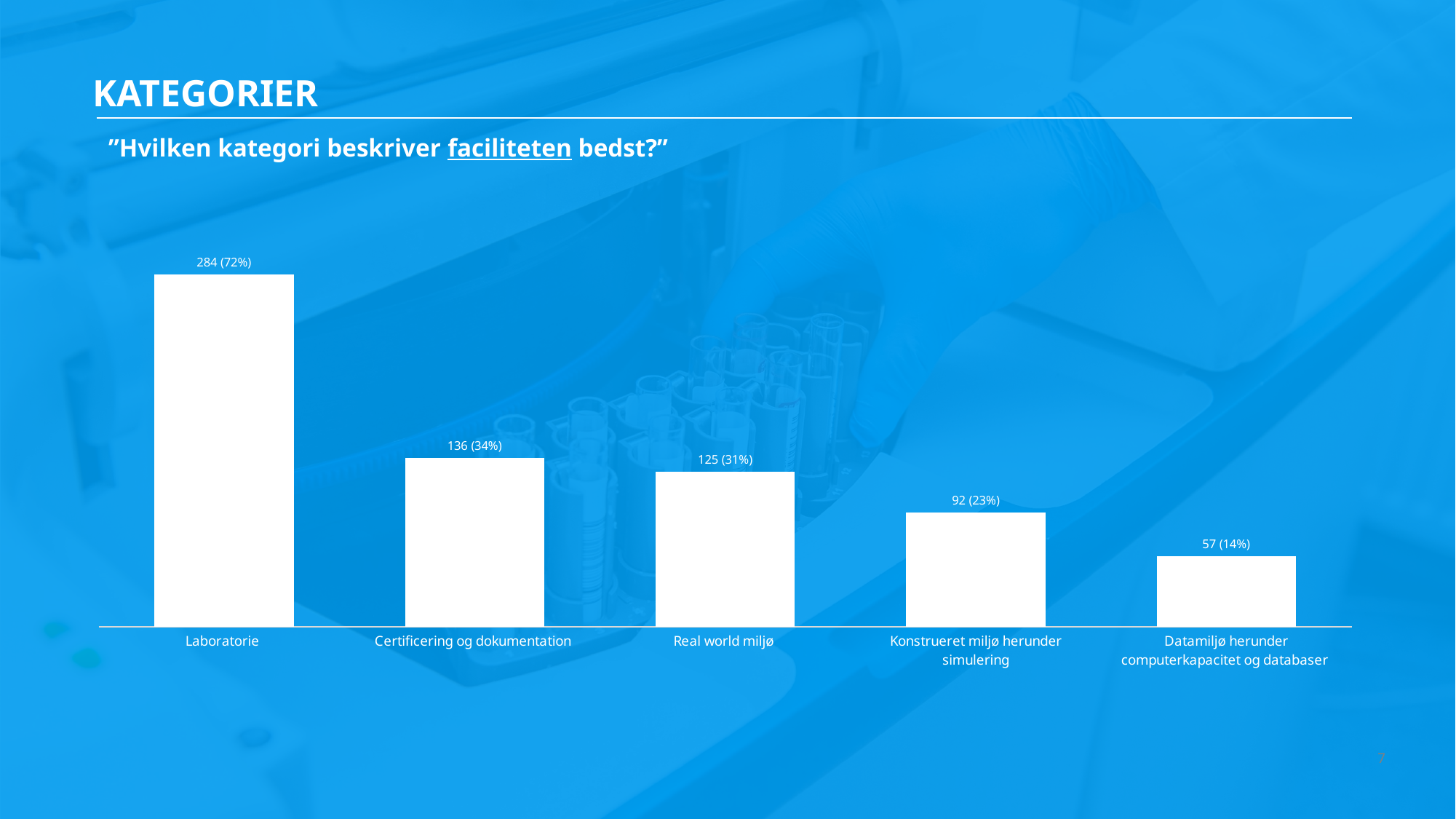
Which category has the highest value? Laboratorie What is the value shown for Konstrueret miljø herunder simulering? 92 (23%) Which category has the lowest value? Datamiljø herunder computerkapacitet og databaser What is the value shown for Certificering og dokumentation? 136 (34%) What is the difference in count between Laboratorie and Certificering og dokumentation? 148 What is the value shown for Datamiljø herunder computerkapacitet og databaser? 57 (14%) Which has a larger value, Certificering og dokumentation or Real world miljø? Certificering og dokumentation How many categories are shown in the chart? 5 What kind of chart is shown on the slide? Bar chart What is the difference in count between Real world miljø and Konstrueret miljø herunder simulering? 33 What is the value shown for Laboratorie? 284 (72%) What is the value shown for Real world miljø? 125 (31%)